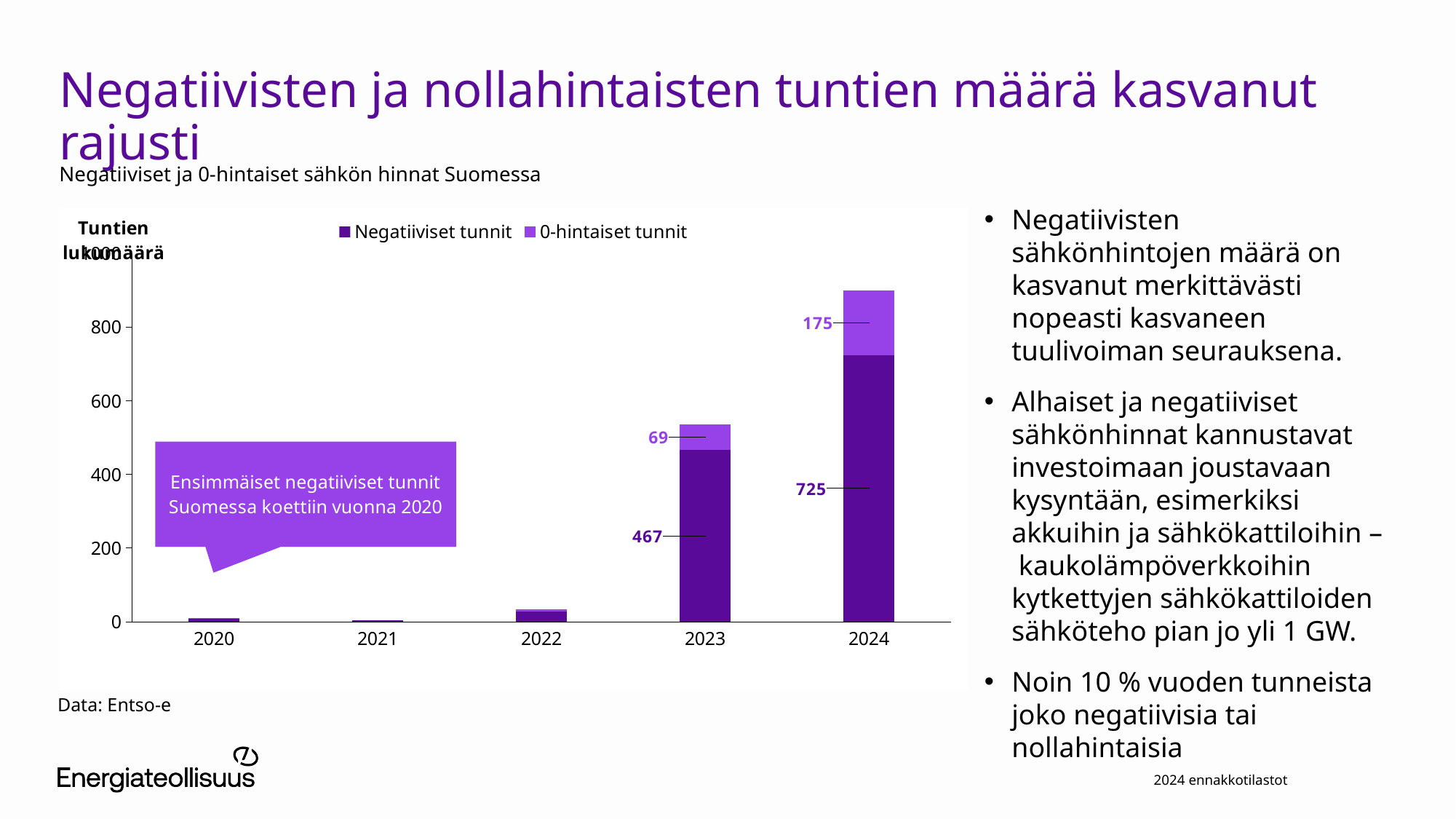
What is the value of 0-hintaiset tunnit for 2024? 175 What is the total height of the stacked bar for 2024? 900 What is the difference between the Negatiiviset tunnit values for 2024 and 2023? 258 What is the total height of the stacked bar for 2023? 536 What is the value of 0-hintaiset tunnit for 2023? 69 How many years are shown on the x axis? 5 Which year has the tallest stacked bar? 2024 Do the bar heights rise or fall from 2020 to 2024? rise Is the value for Negatiiviset tunnit in 2022 greater or less than 200? less How many negative-price hours (Negatiiviset tunnit) are shown for 2023? 467 What is the value of Negatiiviset tunnit for 2024? 725 How many series does the legend list? 2